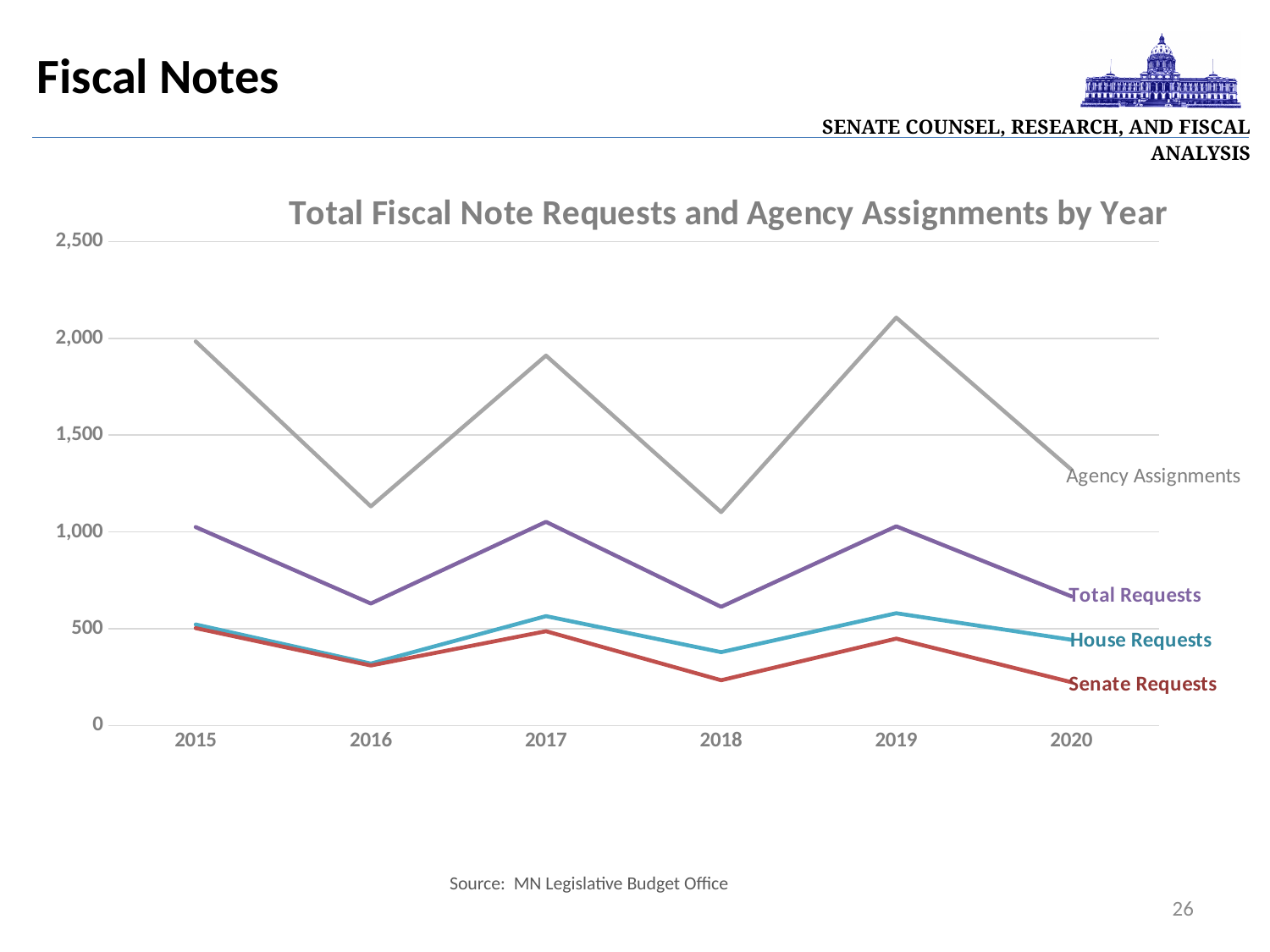
Is the value for Total Requests in 2016 greater or less than 500? greater What is the title of the chart? Total Fiscal Note Requests and Agency Assignments by Year Is the value for Senate Requests in 2018 greater or less than 500? less How many years are shown on the x axis of the chart? 6 In 2020, which is larger: House Requests or Senate Requests? House Requests What kind of chart is shown on the slide? line chart How many series are plotted in the chart? 4 Does Agency Assignments rise or fall from 2019 to 2020? fall In which year is Agency Assignments at its highest? 2019 Is the value for Agency Assignments in 2018 greater or less than 1,500? less